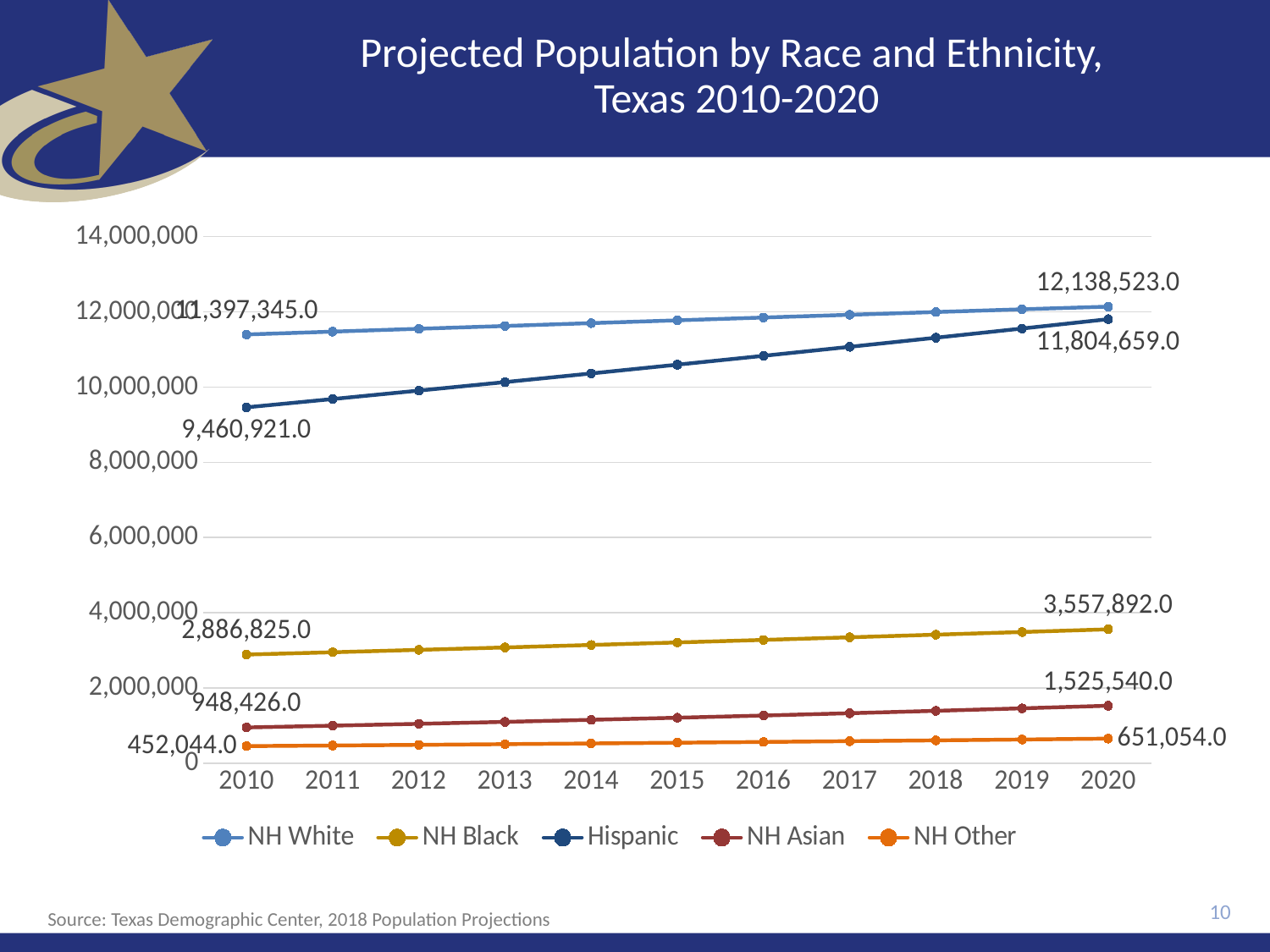
What kind of chart is shown on the slide? line chart How many series does the legend list? 5 What is the projected NH Other population in 2020? 651,054.0 By how much is the Hispanic population projected to grow from 2010 to 2020? 2,343,738.0 How many years are plotted along the x axis? 11 What is the Hispanic population value shown for 2010? 9,460,921.0 What is the projected Hispanic population in 2020? 11,804,659.0 What is the projected NH Black population in 2020? 3,557,892.0 Which group has the highest projected population in 2020? NH White What is the NH Asian population value shown for 2010? 948,426.0 What is the projected NH White population in 2020? 12,138,523.0 Is the NH Black value for 2015 greater or less than 4,000,000? less